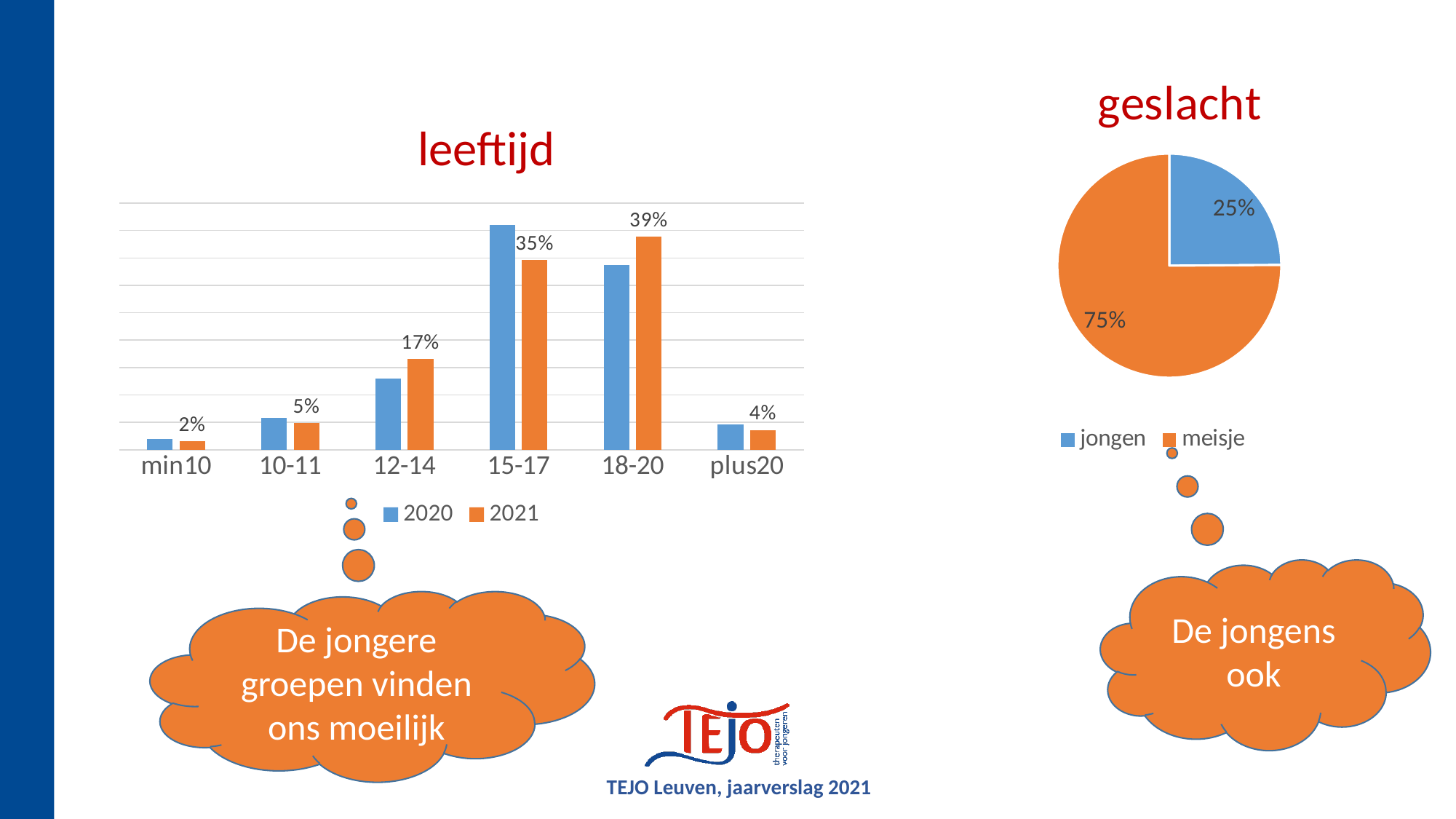
In the 'leeftijd' chart, what is the 2021 value for the 12-14 age group? 17% What kind of chart is the 'leeftijd' chart? bar chart In the 'geslacht' chart, what share of the pie does jongen represent? 25% In the 'leeftijd' chart, how many series does the legend list? 2 In the 'leeftijd' chart, for the 15-17 age group, which series has the larger value, 2020 or 2021? 2020 In the 'geslacht' chart, what percentage is shown for meisje? 75% What kind of chart is the 'geslacht' chart? pie chart In the 'leeftijd' chart, how many age groups are shown on the x axis? 6 In the 'leeftijd' chart, which age group has the lowest 2021 value? min10 In the 'leeftijd' chart, what is the 2021 value for the 18-20 age group? 39% In the 'leeftijd' chart, what is the difference between the 2021 values for 18-20 and 15-17? 4% In the 'leeftijd' chart, which age group has the highest 2021 value? 18-20